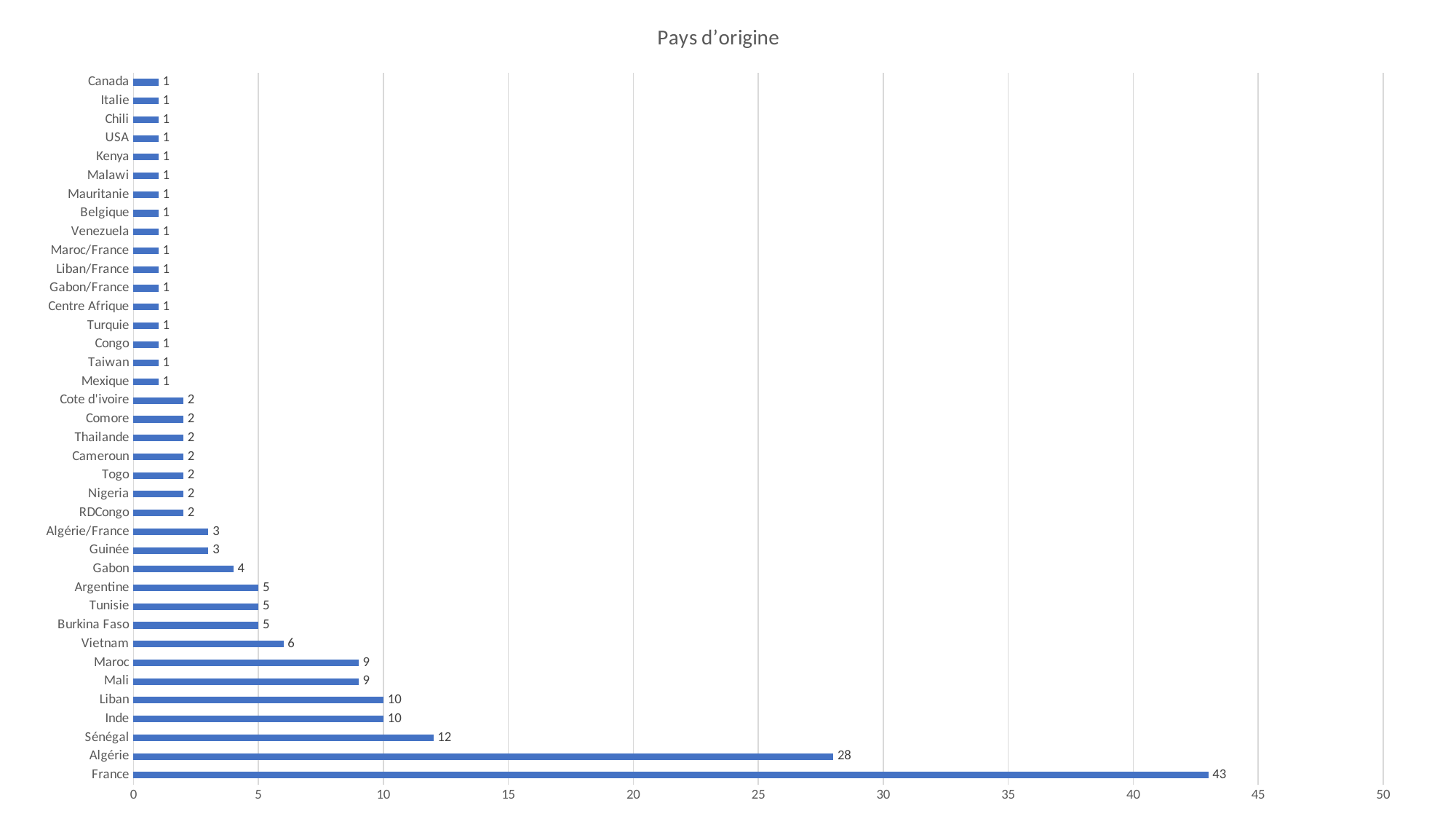
What is the value for Vietnam? 6 What is the value for France? 43 How many categories are shown on the chart? 38 What is the difference between the values for Sénégal and Maroc? 3 Which country has the highest value? France Is the value for Algérie greater or less than 25? greater What is the value for Sénégal? 12 What is the title of the chart? Pays d'origine Which has a larger value, Gabon or Guinée? Gabon What is the difference between the values for France and Algérie? 15 What kind of chart is this? Bar chart What is the value for Algérie? 28